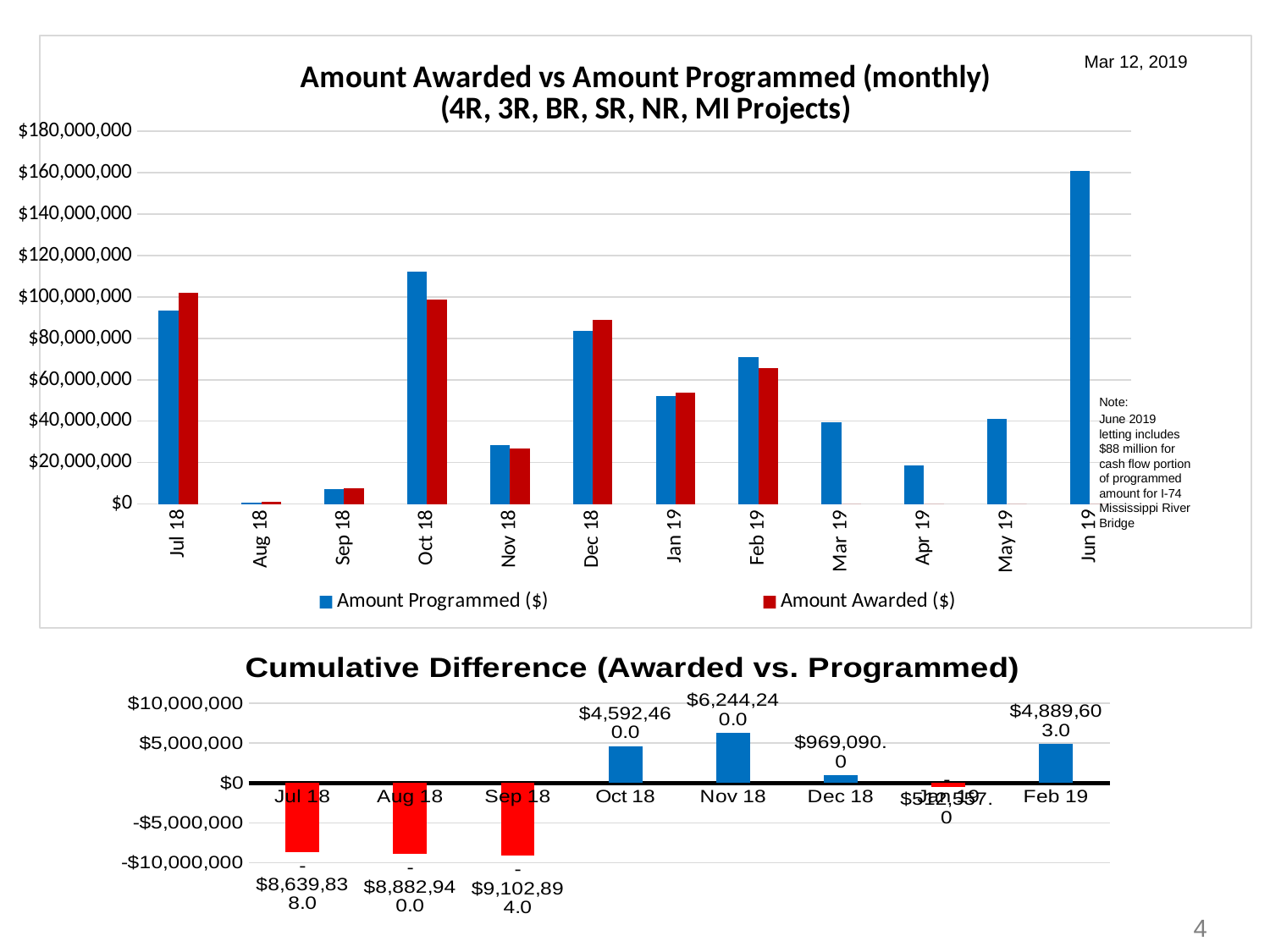
In the bottom chart 'Cumulative Difference (Awarded vs. Programmed)', what is the value for Nov 18? $6,244,240.0 In the top chart 'Amount Awarded vs Amount Programmed (monthly)', how many series does the legend list? 2 In the top chart 'Amount Awarded vs Amount Programmed (monthly)', is the Amount Programmed ($) for Oct 18 greater or less than $100,000,000? greater What kind of chart is the top chart titled 'Amount Awarded vs Amount Programmed (monthly)'? Bar chart In the top chart 'Amount Awarded vs Amount Programmed (monthly)', is the Amount Programmed ($) for Jun 19 greater or less than $140,000,000? greater In the top chart 'Amount Awarded vs Amount Programmed (monthly)', for Oct 18, which is larger: Amount Programmed ($) or Amount Awarded ($)? Amount Programmed ($) In the bottom chart 'Cumulative Difference (Awarded vs. Programmed)', what is the value for Sep 18? -$9,102,894.0 In the top chart 'Amount Awarded vs Amount Programmed (monthly)', which month has the highest Amount Programmed ($)? Jun 19 In the top chart 'Amount Awarded vs Amount Programmed (monthly)', how many months are shown on the x axis? 12 In the bottom chart 'Cumulative Difference (Awarded vs. Programmed)', how many months are plotted? 8 In the bottom chart 'Cumulative Difference (Awarded vs. Programmed)', which month has the lowest value? Sep 18 In the top chart 'Amount Awarded vs Amount Programmed (monthly)', for Jul 18, which is larger: Amount Programmed ($) or Amount Awarded ($)? Amount Awarded ($)